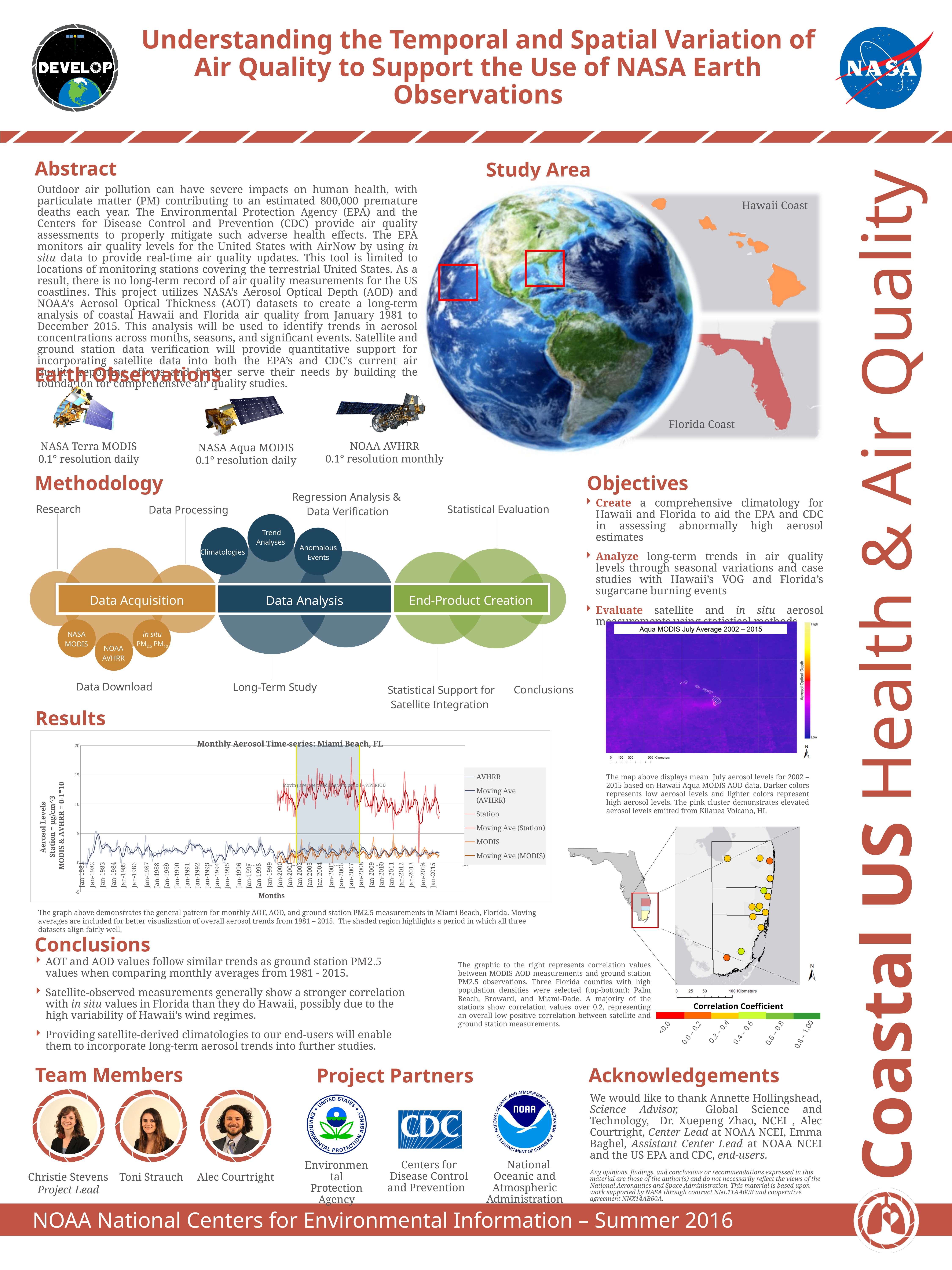
In the Monthly Aerosol Time-series chart, is the MODIS value around Jan-2010 greater or less than 5? less What kind of chart is the Monthly Aerosol Time-series: Miami Beach, FL chart? line chart What is the x-axis label of the Monthly Aerosol Time-series chart? Months In the Monthly Aerosol Time-series chart, is the Moving Ave (Station) value around Jan-2005 greater or less than 15? less In the Monthly Aerosol Time-series chart, which is larger around Jan-2005: the Station value or the AVHRR value? Station In the Monthly Aerosol Time-series chart, is the Station value around Jan-2003 greater or less than 5? greater In the Monthly Aerosol Time-series chart, which series has the highest values during the shaded 2002–2007 period? Station What is the title of the chart in the Results section? Monthly Aerosol Time-series: Miami Beach, FL How many series does the legend of the Monthly Aerosol Time-series chart list? 6